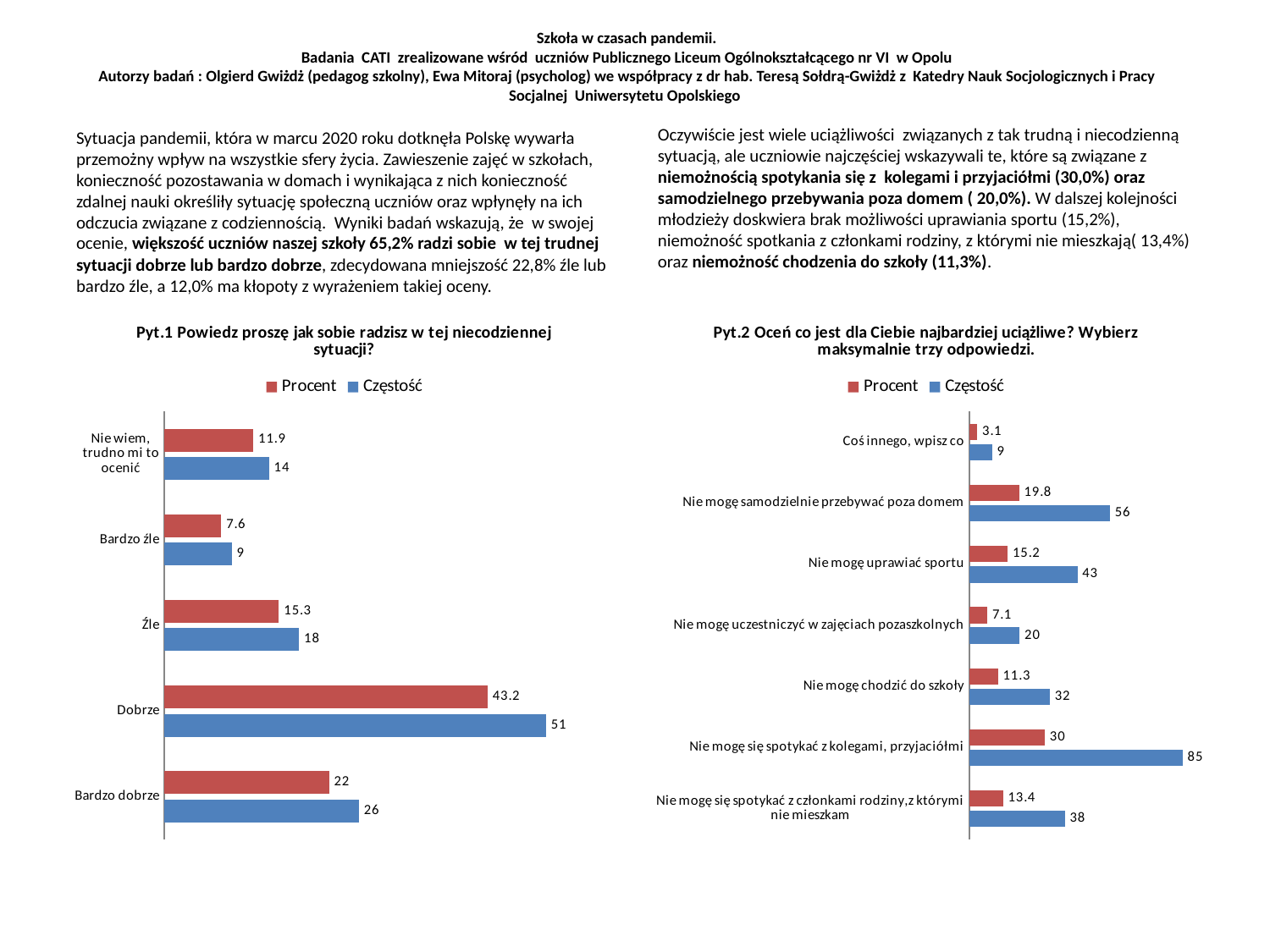
In the chart 'Pyt.2 Oceń co jest dla Ciebie najbardziej uciążliwe?', how many series does the legend list? 2 In the chart 'Pyt.1 Powiedz proszę jak sobie radzisz w tej niecodziennej sytuacji?', which category has the lowest Procent value? Bardzo źle In the chart 'Pyt.1 Powiedz proszę jak sobie radzisz w tej niecodziennej sytuacji?', how many categories are shown? 5 In the chart 'Pyt.1 Powiedz proszę jak sobie radzisz w tej niecodziennej sytuacji?', what is the difference between the Częstość values for 'Bardzo dobrze' and 'Źle'? 8 In the chart 'Pyt.2 Oceń co jest dla Ciebie najbardziej uciążliwe?', what is the Częstość value for 'Nie mogę się spotykać z kolegami, przyjaciółmi'? 85 In the chart 'Pyt.1 Powiedz proszę jak sobie radzisz w tej niecodziennej sytuacji?', what is the Procent value for 'Bardzo źle'? 7.6 In the chart 'Pyt.2 Oceń co jest dla Ciebie najbardziej uciążliwe?', which is larger: the Częstość value for 'Nie mogę uprawiać sportu' or for 'Nie mogę się spotykać z członkami rodziny, z którymi nie mieszkam'? Nie mogę uprawiać sportu In the chart 'Pyt.1 Powiedz proszę jak sobie radzisz w tej niecodziennej sytuacji?', which category has the highest Częstość value? Dobrze In the chart 'Pyt.1 Powiedz proszę jak sobie radzisz w tej niecodziennej sytuacji?', what is the Częstość value for 'Dobrze'? 51 What type of chart is 'Pyt.2 Oceń co jest dla Ciebie najbardziej uciążliwe?'? Bar chart In the chart 'Pyt.2 Oceń co jest dla Ciebie najbardziej uciążliwe?', what is the Procent value for 'Nie mogę chodzić do szkoły'? 11.3 In the chart 'Pyt.2 Oceń co jest dla Ciebie najbardziej uciążliwe?', which category has the lowest Częstość value? Coś innego, wpisz co